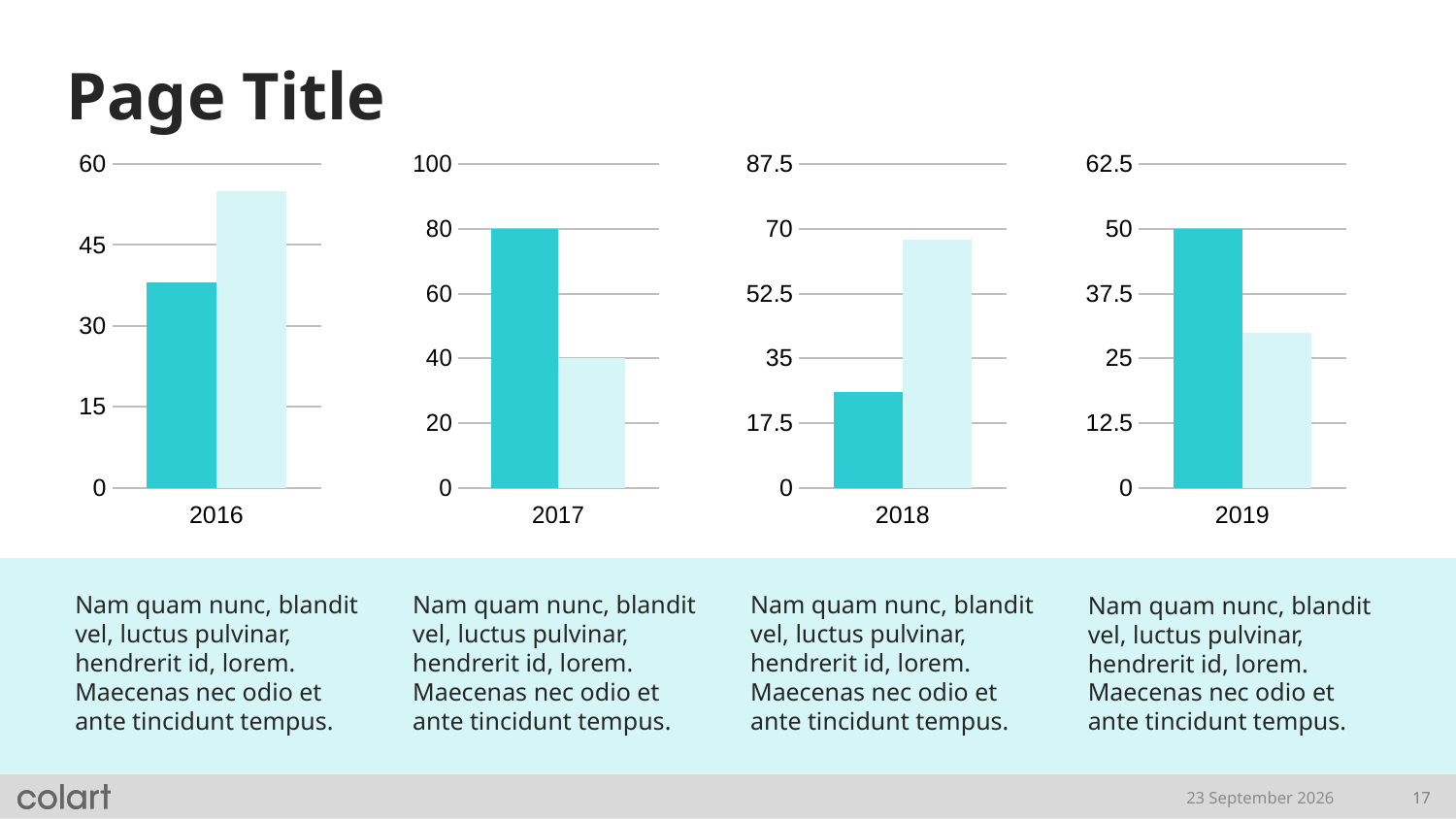
What is the highest value shown on the vertical axis of the chart labelled 2017? 100 In the chart labelled 2016, which bar is taller, the dark teal bar or the light teal bar? the light teal bar In the chart labelled 2017, what is the difference between the dark teal bar and the light teal bar? 40 In the chart labelled 2016, is the value of the dark teal bar greater or less than 45? less In the chart labelled 2018, which bar is taller, the dark teal bar or the light teal bar? the light teal bar In the chart labelled 2017, what value does the dark teal bar reach? 80 What kind of chart is the chart labelled 2016? bar chart In the chart labelled 2019, which bar is shorter, the dark teal bar or the light teal bar? the light teal bar In the chart labelled 2018, is the value of the light teal bar greater or less than 52.5? greater In the chart labelled 2019, what value does the dark teal bar reach? 50 How many bars are plotted in the chart labelled 2018? 2 In the chart labelled 2017, what value does the light teal bar reach? 40